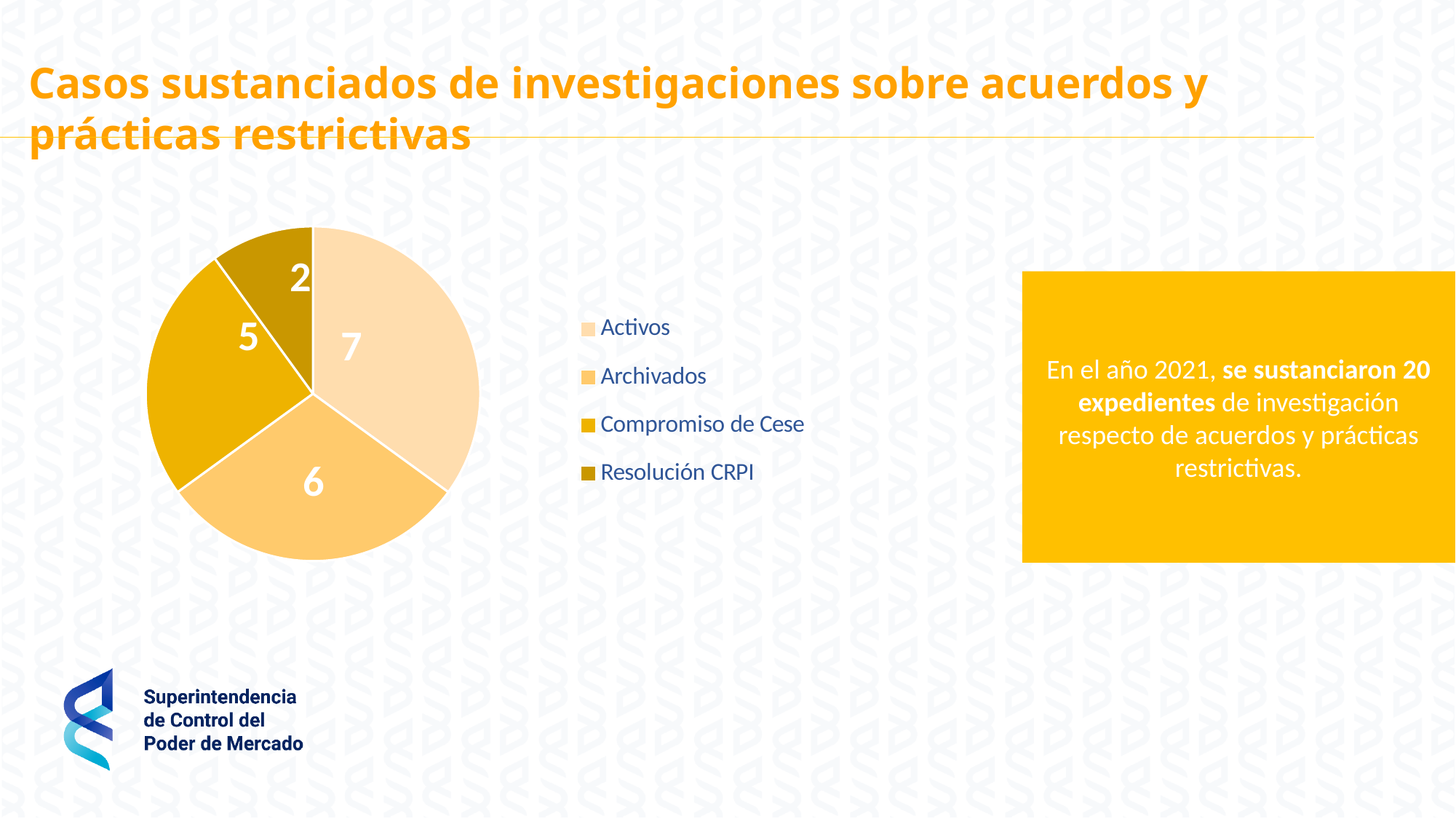
What is the difference between the values for Activos and Resolución CRPI? 5 What is the value for Compromiso de Cese? 5 What kind of chart is shown on the slide? Pie chart Which is larger, the value for Archivados or the value for Compromiso de Cese? Archivados What is the value for Archivados? 6 What is the value for Resolución CRPI? 2 What is the total of all the slices in the pie chart? 20 How many categories does the pie chart show? 4 Which category has the largest slice of the pie? Activos Which category has the smallest slice of the pie? Resolución CRPI What is the value for Activos? 7 What share of the pie does Compromiso de Cese represent? 25%